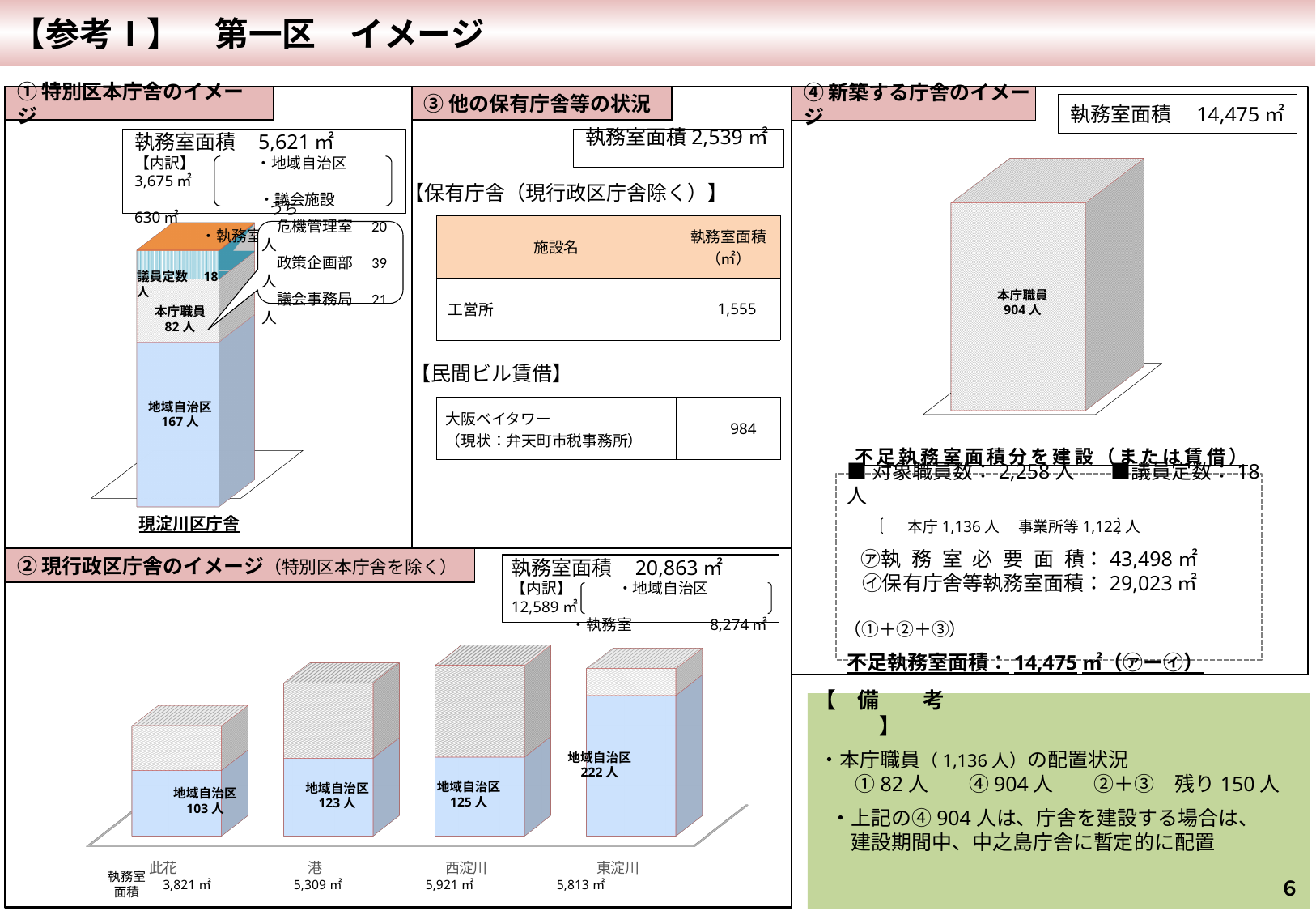
In the ② 現行政区庁舎のイメージ chart, which ward has the lowest 地域自治区 staff count? 此花 In the ② 現行政区庁舎のイメージ chart, what is the 執務室面積 for 西淀川? 5,921 ㎡ In the ② 現行政区庁舎のイメージ chart, what is the difference in 地域自治区 staff between 東淀川 and 此花? 119人 In the ④ 新築する庁舎のイメージ diagram, how many 本庁職員 are shown? 904人 In the ② 現行政区庁舎のイメージ chart, how many 地域自治区 staff are shown for 此花? 103人 In the ② 現行政区庁舎のイメージ chart, how many wards are shown? 4 In the ② 現行政区庁舎のイメージ chart, which ward has the highest 地域自治区 staff count? 東淀川 In the ② 現行政区庁舎のイメージ chart, how many 地域自治区 staff are shown for 港? 123人 In the ② 現行政区庁舎のイメージ chart, which has the larger 執務室面積, 西淀川 or 東淀川? 西淀川 In the ② 現行政区庁舎のイメージ chart, how many 地域自治区 staff are shown for 東淀川? 222人 In the ② 現行政区庁舎のイメージ chart, what is the 執務室面積 for 港? 5,309 ㎡ In the ① 特別区本庁舎のイメージ diagram, what is the total number of people shown in the stacked 現淀川区庁舎 block (地域自治区, 本庁職員, 議員定数)? 267人